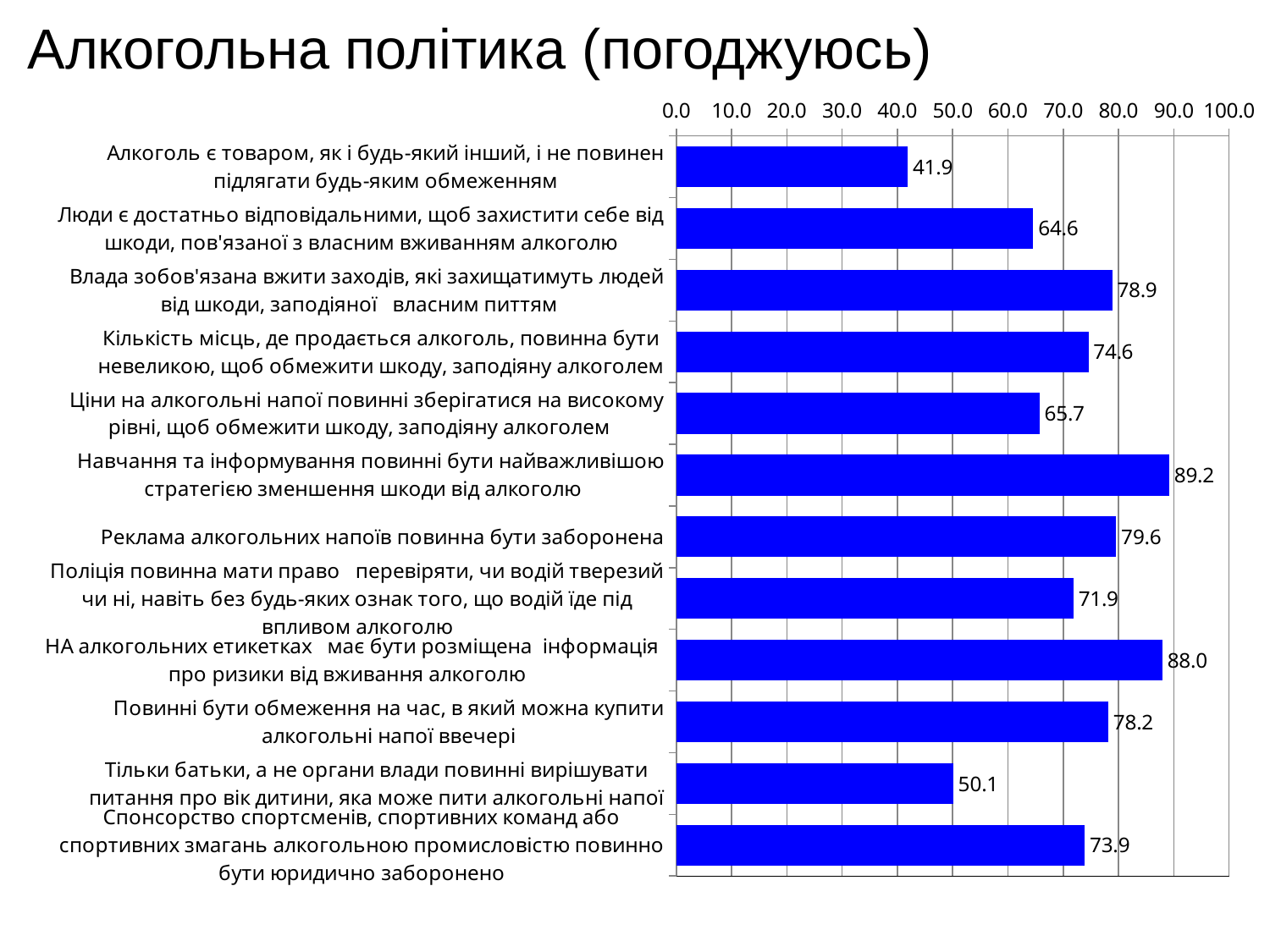
Is the value for "Кількість місць, де продається алкоголь, повинна бути невеликою, щоб обмежити шкоду, заподіяну алкоголем" greater or less than 70.0? greater Which statement has the highest value? Навчання та інформування повинні бути найважливішою стратегією зменшення шкоди від алкоголю What is the difference between the value for "НА алкогольних етикетках має бути розміщена інформація про ризики від вживання алкоголю" and the value for "Тільки батьки, а не органи влади повинні вирішувати питання про вік дитини, яка може пити алкогольні напої"? 37.9 What is the difference between the highest value (89.2) and the lowest value (41.9)? 47.3 Which is larger: the value for "Реклама алкогольних напоїв повинна бути заборонена" or the value for "Влада зобов'язана вжити заходів, які захищатимуть людей від шкоди, заподіяної власним питтям"? Реклама алкогольних напоїв повинна бути заборонена How many categories (statements) are plotted in the chart? 12 What type of chart is shown on the slide? bar chart Which statement has the lowest value? Алкоголь є товаром, як і будь-який інший, і не повинен підлягати будь-яким обмеженням What is the value for "Тільки батьки, а не органи влади повинні вирішувати питання про вік дитини, яка може пити алкогольні напої"? 50.1 What is the title of the chart? Алкогольна політика (погоджуюсь) What is the value for "Реклама алкогольних напоїв повинна бути заборонена"? 79.6 What is the value for "Ціни на алкогольні напої повинні зберігатися на високому рівні, щоб обмежити шкоду, заподіяну алкоголем"? 65.7